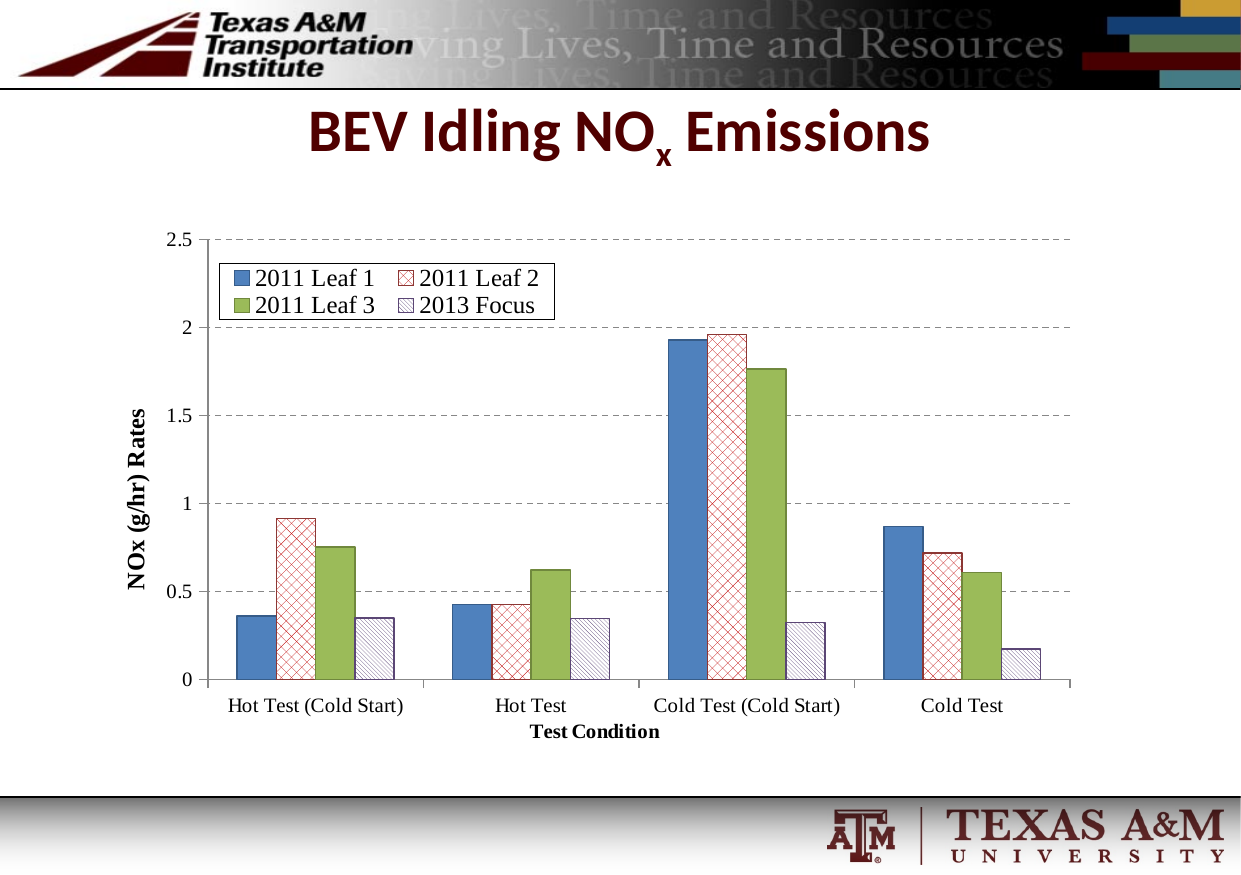
What is the title of the y axis? NOx (g/hr) Rates Is the value for 2013 Focus under Cold Test greater or less than 0.5? less Under Cold Test, which is larger: 2011 Leaf 1 or 2011 Leaf 3? 2011 Leaf 1 How many series does the legend list? 4 For which test condition is the 2011 Leaf 3 value highest? Cold Test (Cold Start) What is the title of the chart? BEV Idling NOx Emissions Is the value for 2011 Leaf 1 under Cold Test (Cold Start) greater or less than 1.5? greater Under Hot Test (Cold Start), which is larger: 2011 Leaf 1 or 2011 Leaf 2? 2011 Leaf 2 How many test conditions are shown on the x axis? 4 Is the value for 2011 Leaf 3 under Hot Test greater or less than 0.5? greater What kind of chart is shown on the slide? bar chart Under Cold Test, which series has the lowest value? 2013 Focus